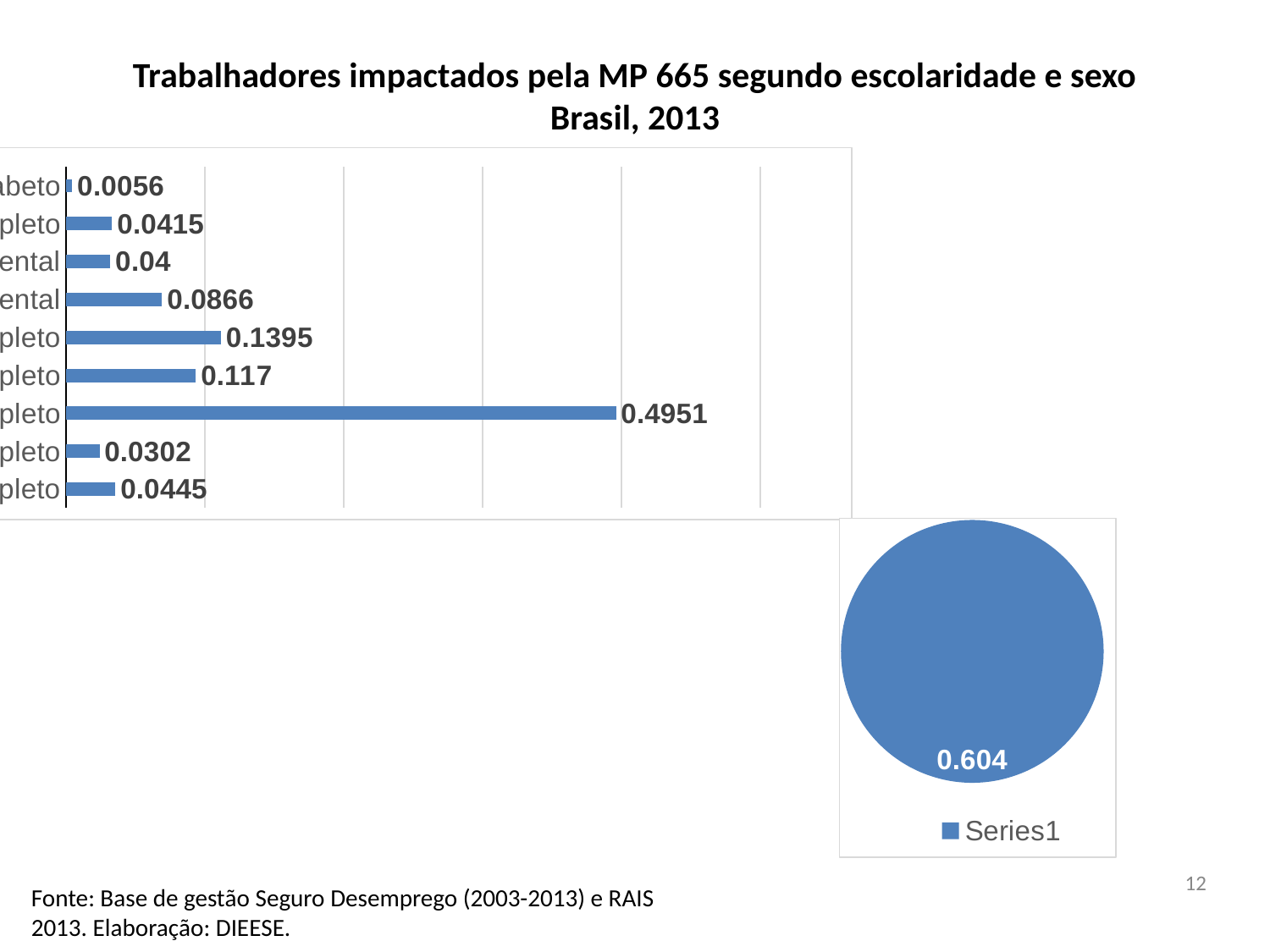
In the bar chart at the top left, what is the difference between the highest value (0.4951) and the lowest value (0.0056)? 0.4895 In the pie chart at the bottom right, what value is printed on the slice? 0.604 In the bar chart at the top left, how many bars are plotted? 9 In the bar chart at the top left, what is the highest value shown? 0.4951 What type of chart is the chart at the bottom right of the slide? pie chart What type of chart is the chart at the top left of the slide? bar chart In the bar chart at the top left, what is the value of the topmost bar? 0.0056 In the bar chart at the top left, what is the value of the bottommost bar? 0.0445 In the bar chart at the top left, what is the lowest value shown? 0.0056 In the bar chart at the top left, which is larger: the topmost bar or the bottommost bar? the bottommost bar In the pie chart at the bottom right, how many series does the legend list? 1